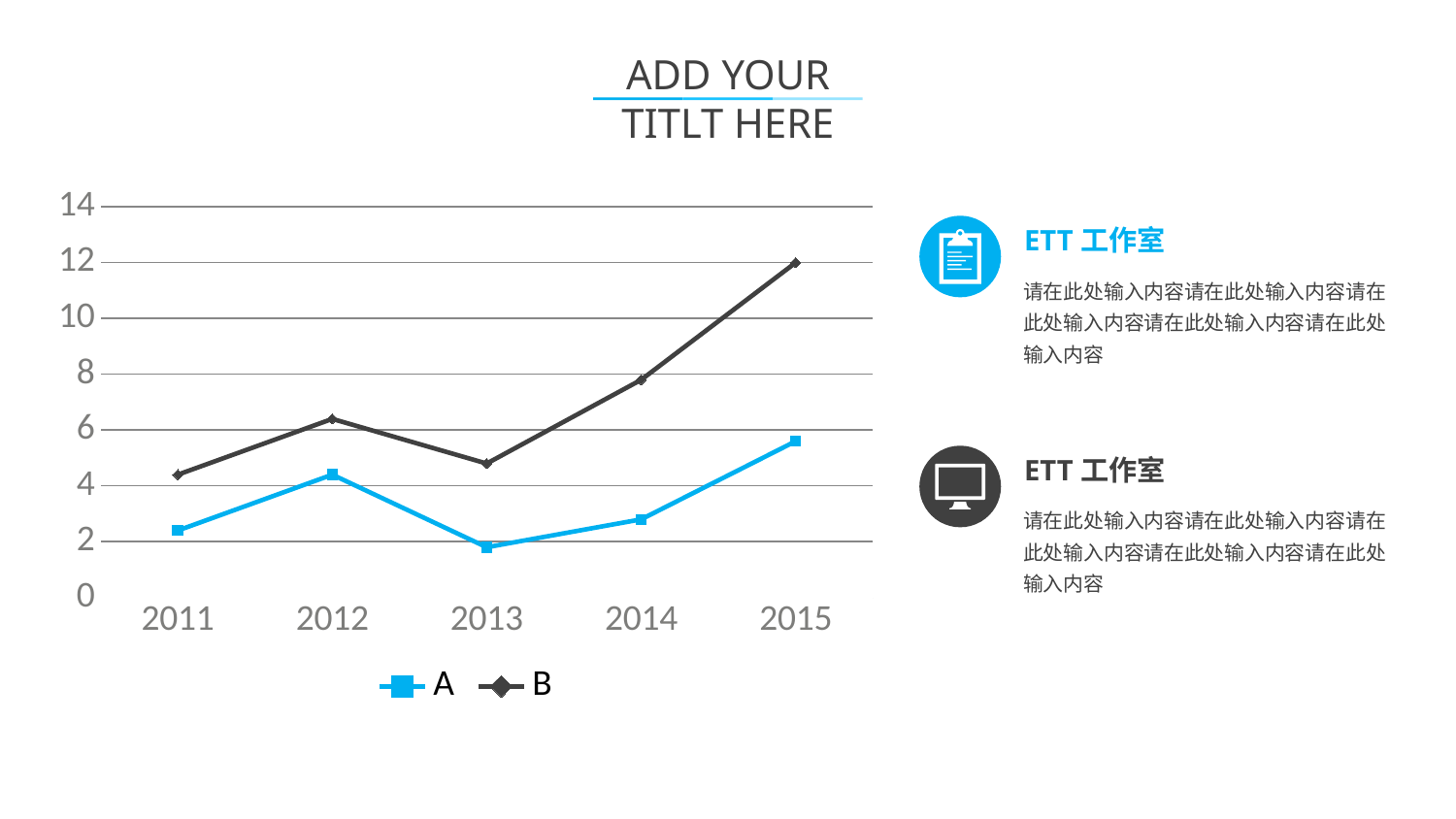
Is the value for series A in 2015 greater or less than 4? greater In which year does series A reach its lowest value? 2013 How many years are shown on the x axis? 5 How many series does the legend list? 2 What colour is the line for series A? blue Which series has the larger value in 2012, A or B? B Does series B rise or fall from 2013 to 2015? rise Is the value for series B in 2014 greater or less than 6? greater In which year does series B reach its highest value? 2015 What is the value of series B in 2015? 12 What kind of chart is shown on the slide? line chart